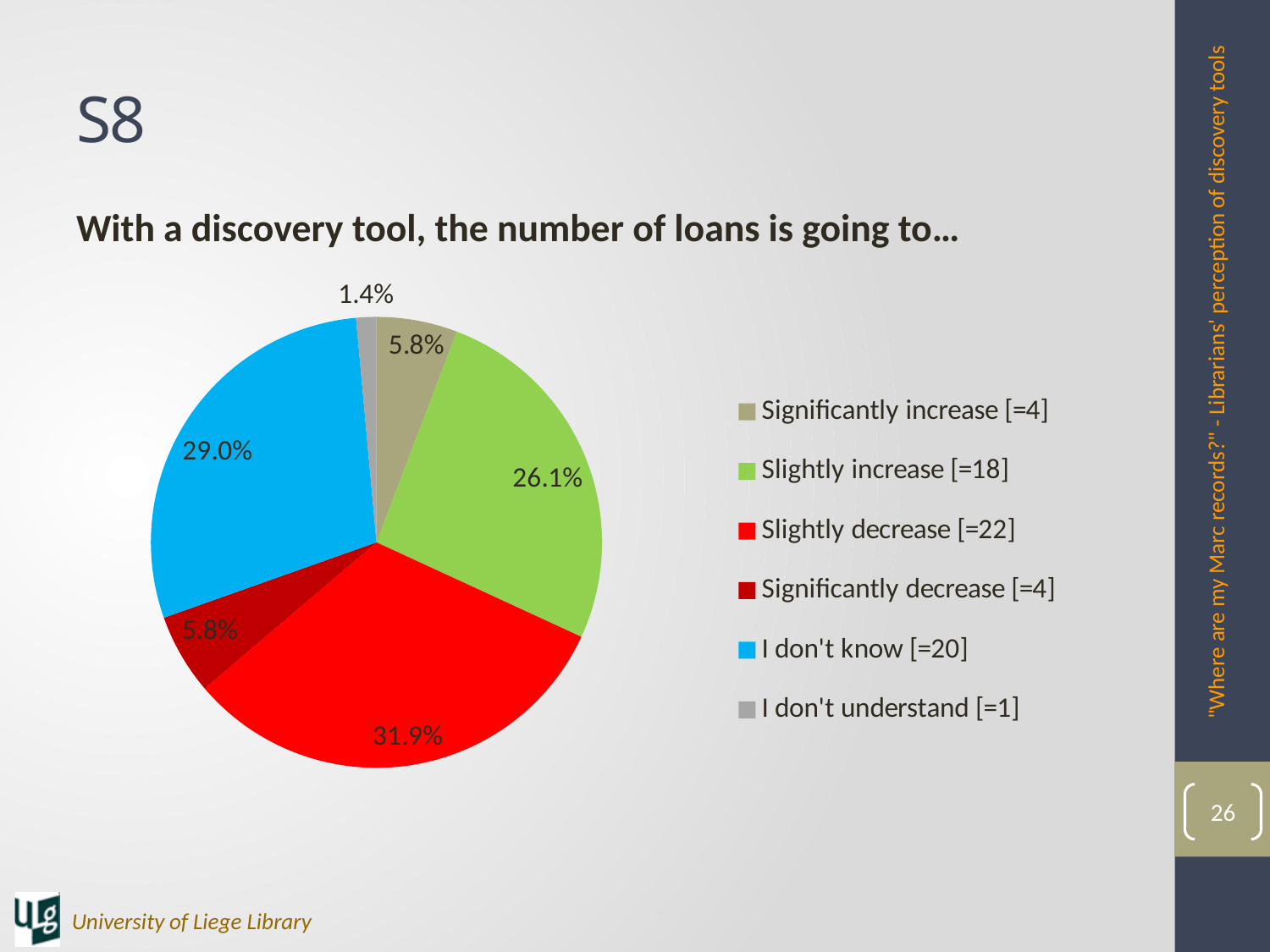
How many respondents chose "Slightly increase" according to the legend? 18 Which category has the largest slice of the pie? Slightly decrease What share of the pie does "Slightly increase" represent? 26.1% What share of the pie does "I don't understand" represent? 1.4% How many categories does the pie chart have? 6 What colour is the "I don't know" slice in the pie chart? light blue What is the difference in percentage points between the "Slightly decrease" and "Slightly increase" shares? 5.8 Which category has the smallest slice of the pie? I don't understand Which is larger: the share for "I don't know" or the share for "Slightly increase"? I don't know What share of the pie does "Slightly decrease" represent? 31.9% What kind of chart is shown on the slide? pie chart